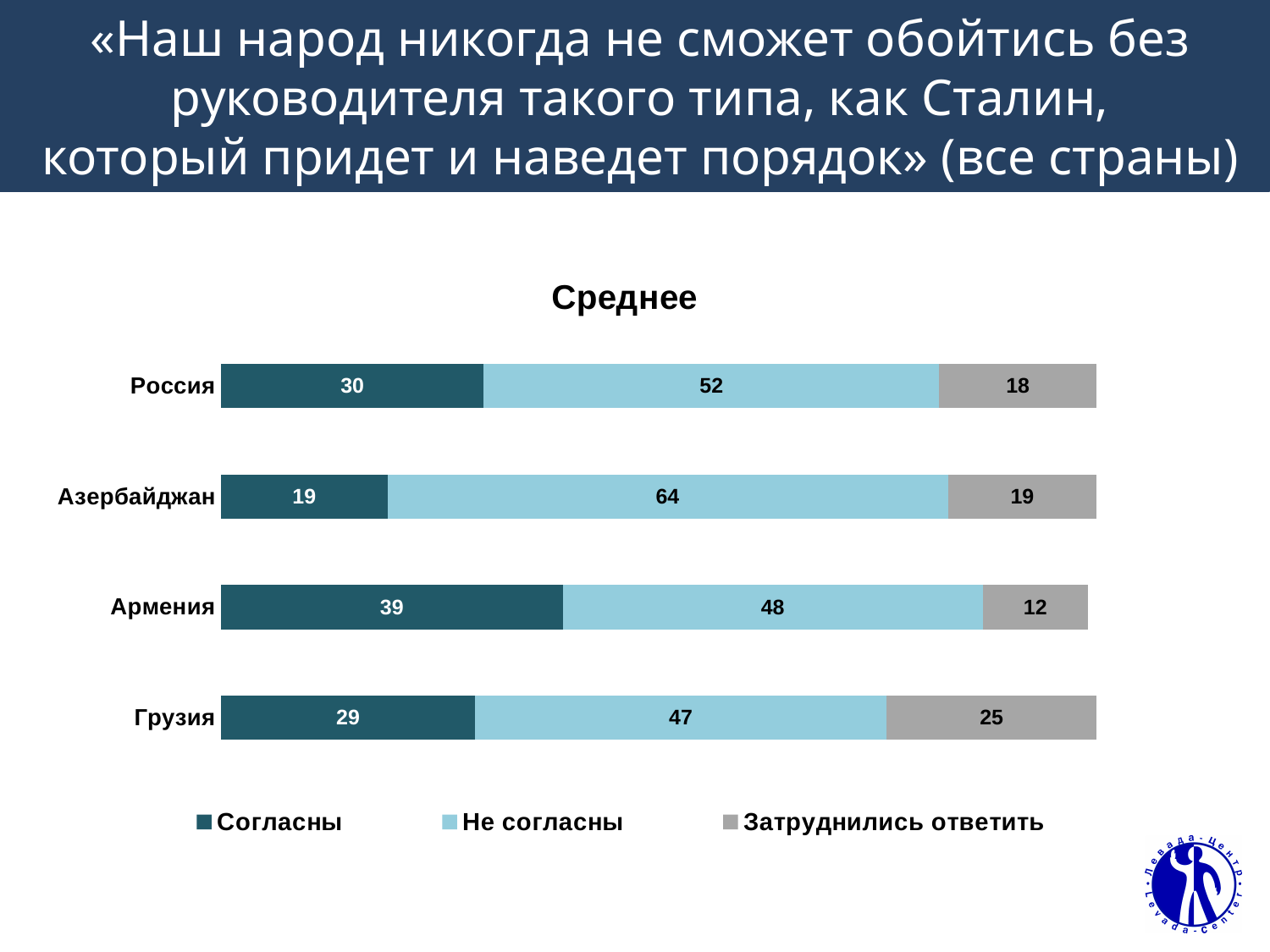
What is the value for "Не согласны" for Азербайджан? 64 Which country has the highest value for "Согласны"? Армения What is the difference between the "Не согласны" values for Азербайджан and Грузия? 17 How many countries are shown in the chart? 4 What is the value for "Затруднились ответить" for Грузия? 25 What is the total of the stacked bar for Армения? 99 How many series does the legend list? 3 Which is larger: the "Согласны" value for Россия or for Азербайджан? Россия What is the title of the chart? Среднее Which country has the lowest value for "Затруднились ответить"? Армения What kind of chart is shown on the slide? Stacked bar chart What is the value for "Согласны" for Россия? 30